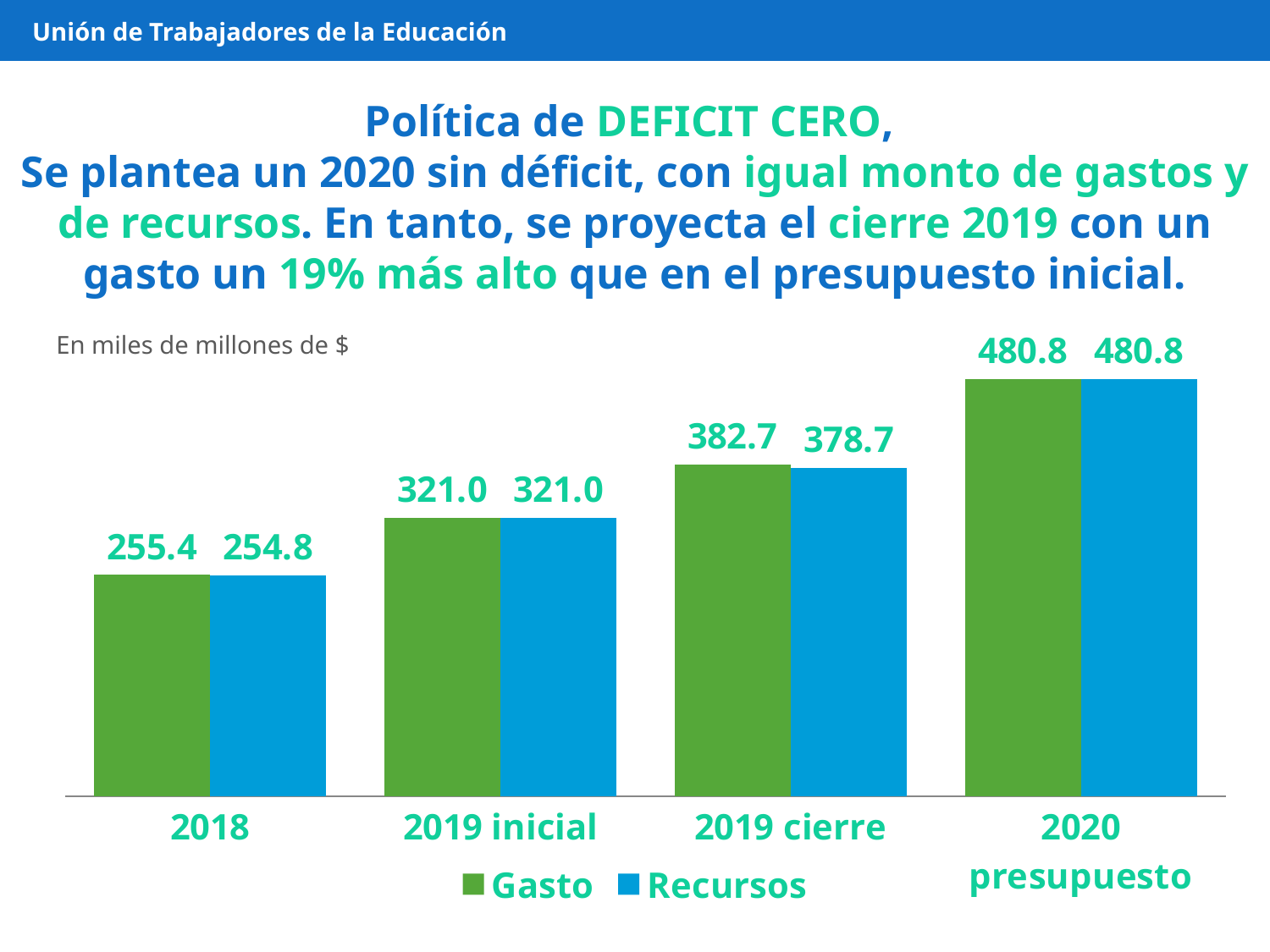
What is the Gasto value for 2018? 255.4 What is the Recursos value for 2019 cierre? 378.7 What is the Gasto value for 2020 presupuesto? 480.8 How many categories are shown on the x axis? 4 What is the difference between Gasto and Recursos for 2019 cierre? 4.0 What kind of chart is shown on the slide? Bar chart Which category has the highest Gasto value? 2020 presupuesto What is the difference between the Gasto values for 2019 cierre and 2019 inicial? 61.7 Which is larger for 2018, Gasto or Recursos? Gasto Which category has the lowest Recursos value? 2018 How many series does the legend list? 2 Do the Gasto values rise or fall from 2018 to 2020 presupuesto? Rise